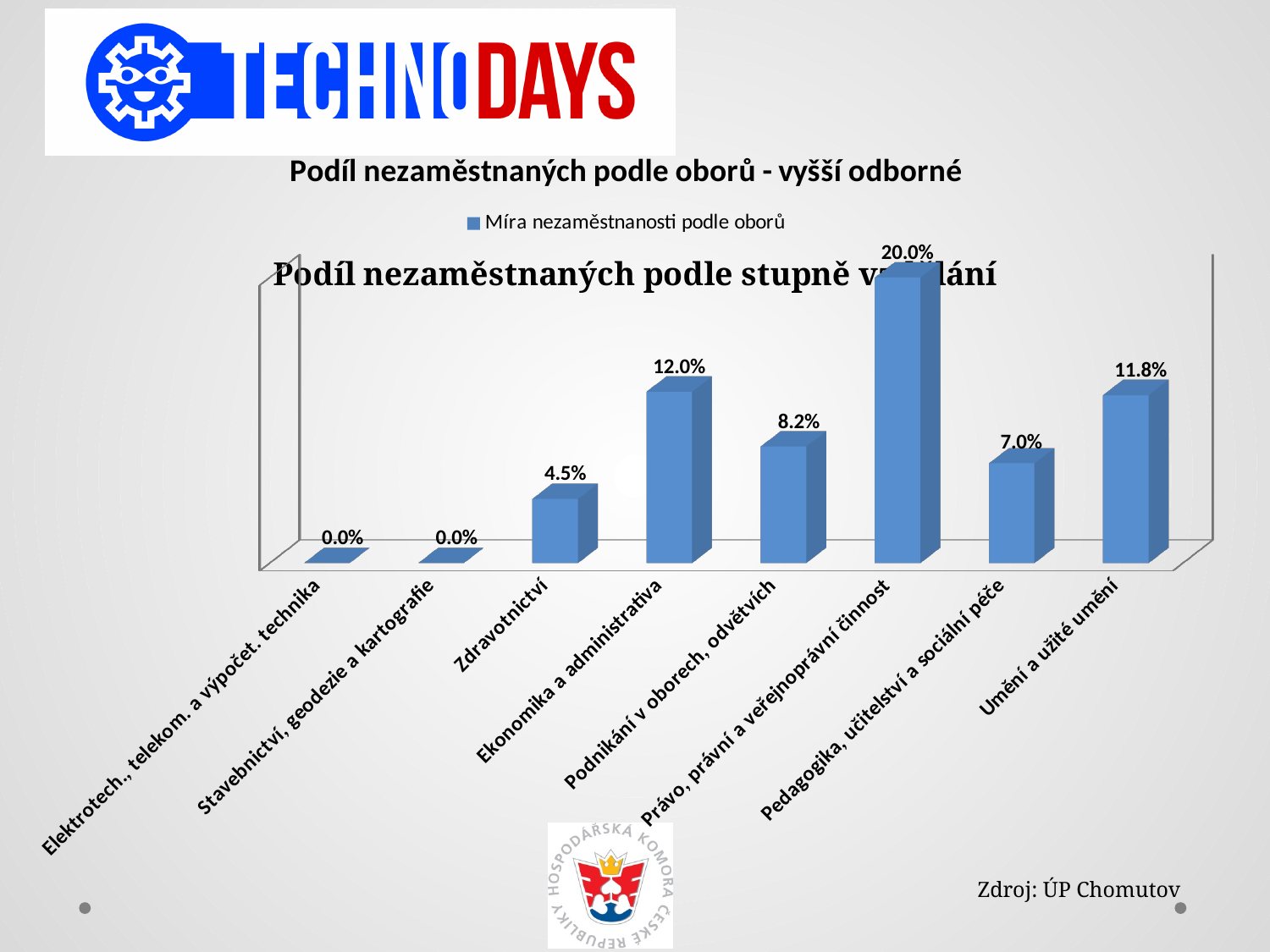
What value is shown for Právo, právní a veřejnoprávní činnost? 20.0% What is the unemployment rate shown for Zdravotnictví? 4.5% What is the difference between the values for Ekonomika a administrativa and Podnikání v oborech, odvětvích? 3.8% What is the difference between the values for Právo, právní a veřejnoprávní činnost and Umění a užité umění? 8.2% How many categories are shown on the x axis? 8 Which category has the highest unemployment rate? Právo, právní a veřejnoprávní činnost What is the legend entry of the chart? Míra nezaměstnanosti podle oborů What is the value for Pedagogika, učitelství a sociální péče? 7.0% Which is larger, the value for Podnikání v oborech, odvětvích or the value for Pedagogika, učitelství a sociální péče? Podnikání v oborech, odvětvích How many series does the legend list? 1 What kind of chart is shown on the slide? Bar chart What value is shown for Umění a užité umění? 11.8%